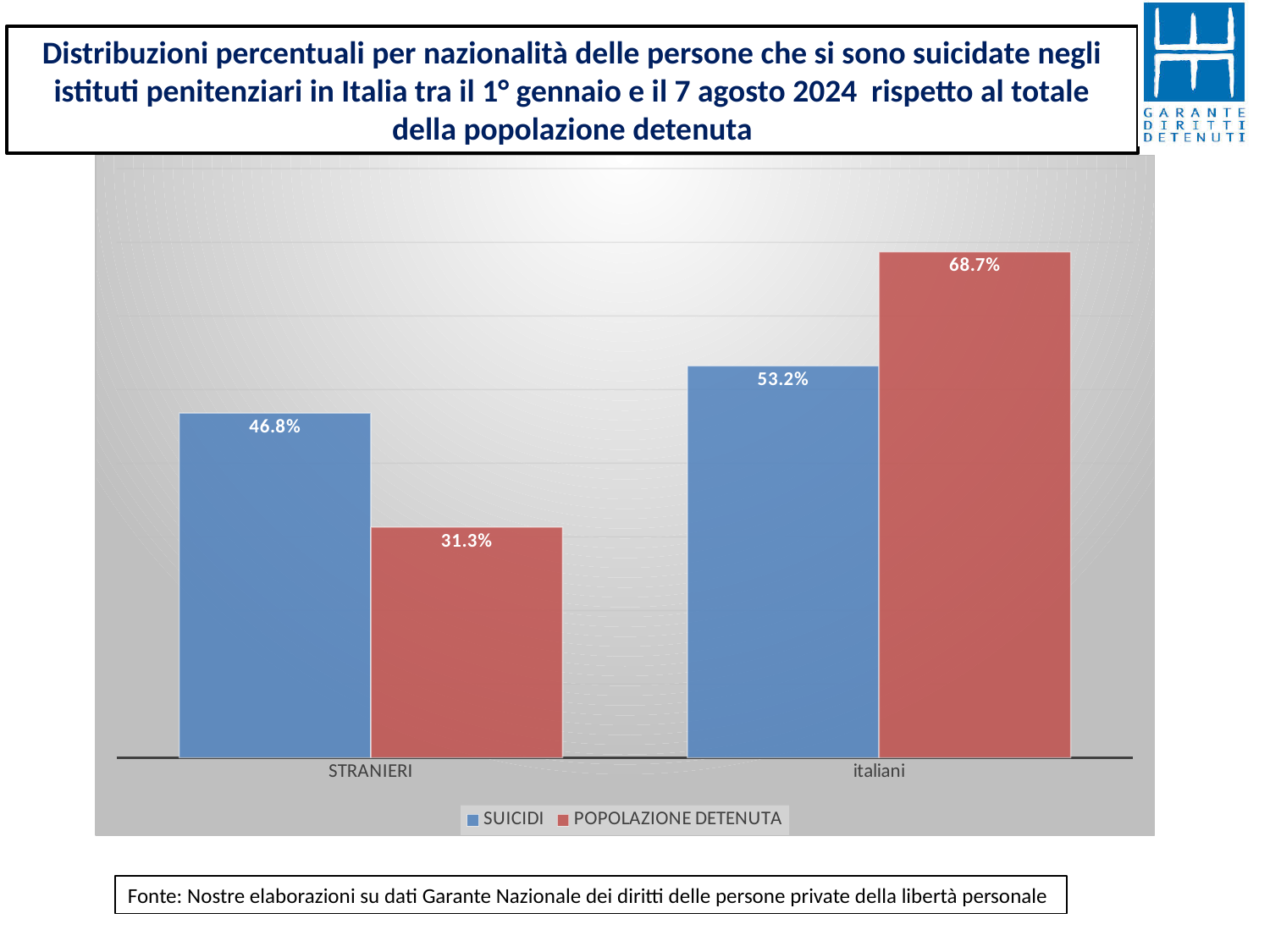
What kind of chart is shown on the slide? Bar chart What is the POPOLAZIONE DETENUTA value for STRANIERI? 31.3% What is the difference between the POPOLAZIONE DETENUTA values for italiani and STRANIERI? 37.4% What is the difference between the SUICIDI values for italiani and STRANIERI? 6.4% What is the SUICIDI value for italiani? 53.2% What is the SUICIDI value for STRANIERI? 46.8% Which category has the highest POPOLAZIONE DETENUTA value? italiani For STRANIERI, which is larger: SUICIDI or POPOLAZIONE DETENUTA? SUICIDI How many series does the legend list? 2 Which category has the lowest SUICIDI value? STRANIERI What is the POPOLAZIONE DETENUTA value for italiani? 68.7% How many categories are shown on the x axis? 2